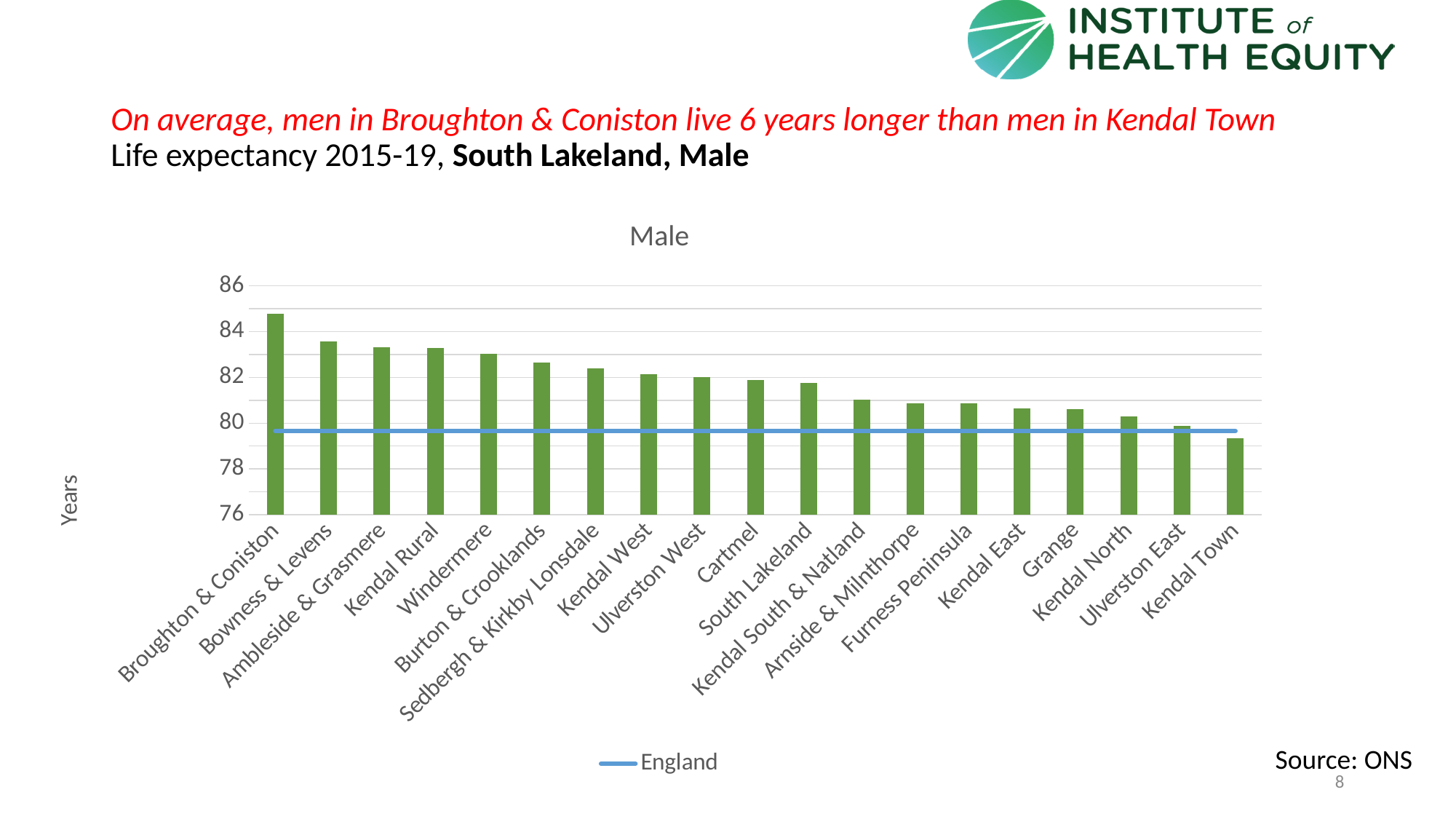
Is the value for Bowness & Levens greater or less than 84? less Do the bar values rise or fall from left to right along the x axis? fall How many areas are plotted as bars in the chart? 19 How many entries does the chart legend list? 1 Which area has the lowest male life expectancy in the chart? Kendal Town What kind of chart is shown on the slide? bar chart Is the value for Broughton & Coniston greater or less than 84? greater Which area has the highest male life expectancy in the chart? Broughton & Coniston Is the value for Windermere greater or less than 82? greater What does the line in the chart represent, according to the legend? England Which has the higher value, Windermere or Grange? Windermere